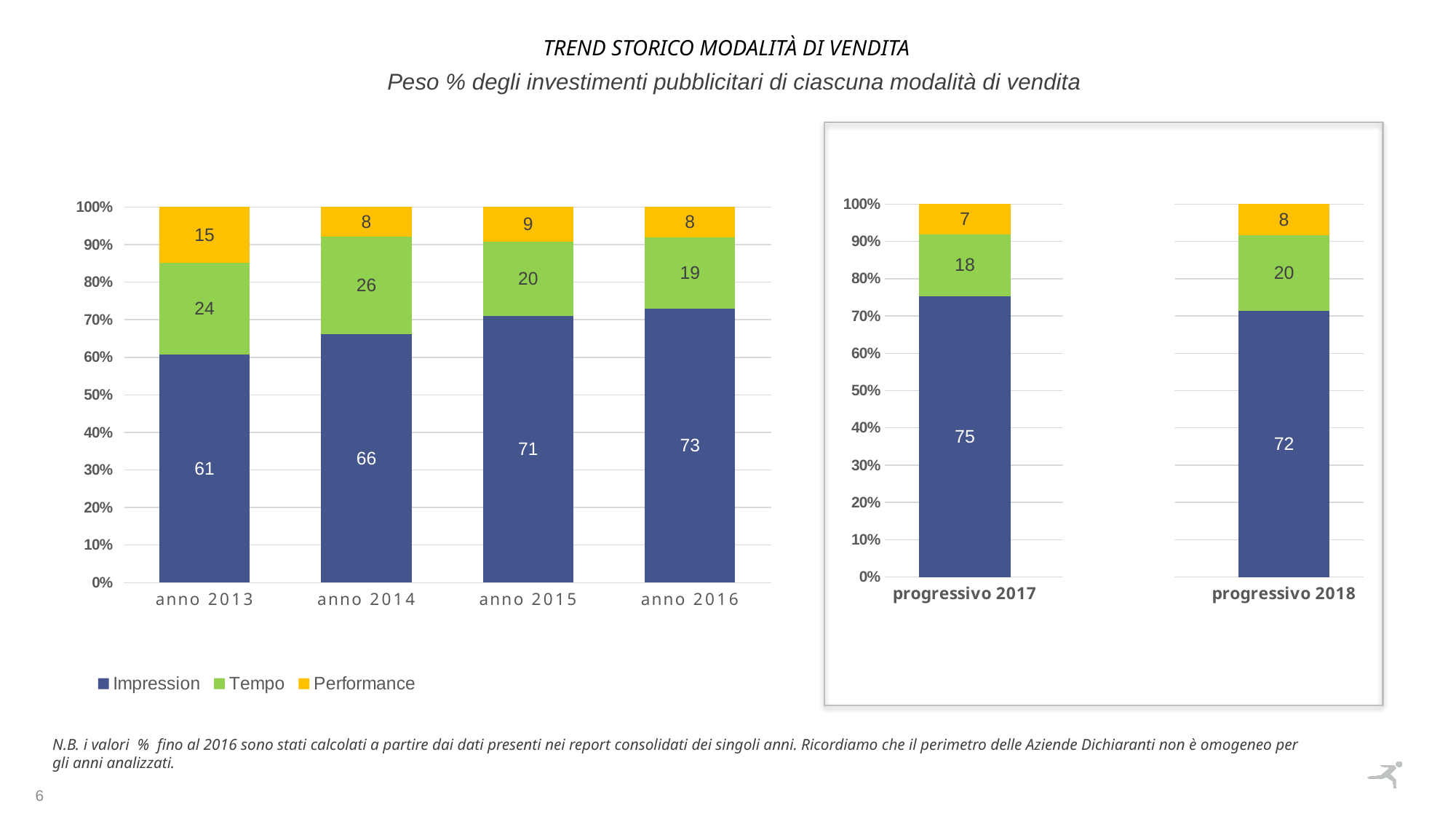
In the right chart, what is the Impression value for progressivo 2017? 75 In the right chart, which is larger: the Impression value for progressivo 2017 or for progressivo 2018? progressivo 2017 In the left chart, what is the Performance value for anno 2015? 9 What kind of chart is the left chart? stacked bar chart In the right chart, what is the Tempo value for progressivo 2018? 20 How many years are shown on the x axis of the left chart? 4 In the left chart, which year has the highest Impression value? anno 2016 How many series does the legend of the left chart list? 3 In the left chart, what is the difference between the Impression values for anno 2016 and anno 2013? 12 In the left chart, does the Impression value rise or fall from anno 2013 to anno 2016? rise In the left chart, what is the Impression value for anno 2013? 61 In the left chart, which year has the lowest Tempo value? anno 2016